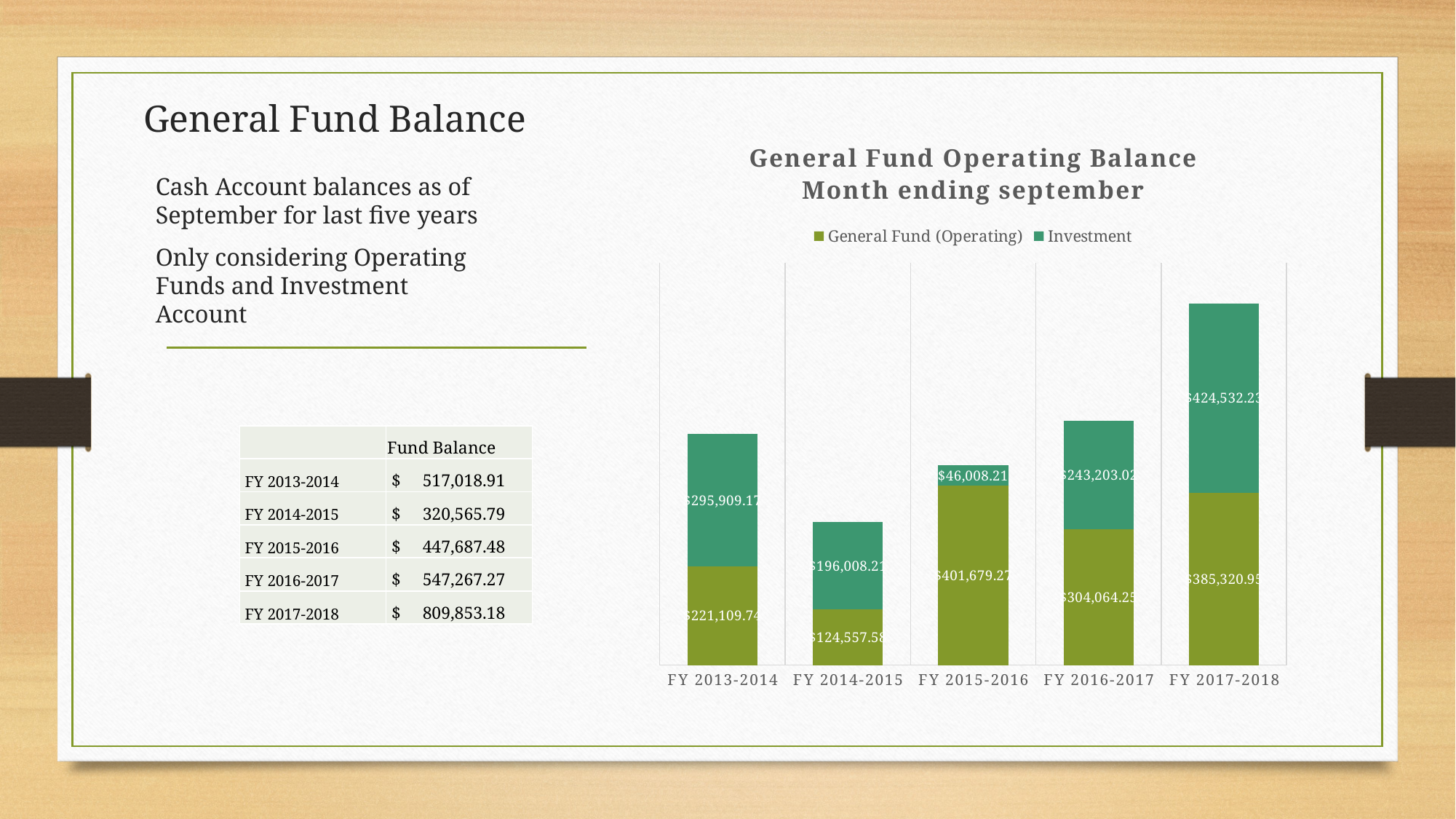
What kind of chart is shown on the slide? Stacked bar chart Which fiscal year has the lowest General Fund (Operating) value? FY 2014-2015 How many fiscal years are shown on the x axis of the chart? 5 Which fiscal year has the highest Investment value? FY 2017-2018 How many series does the chart legend list? 2 What is the difference between the Investment values for FY 2013-2014 and FY 2015-2016? $249,900.96 What is the Investment value for FY 2014-2015? $196,008.21 What is the title of the chart? General Fund Operating Balance Month ending september Which is larger for FY 2016-2017: the General Fund (Operating) value or the Investment value? General Fund (Operating) What is the Investment value for FY 2017-2018? $424,532.23 What is the total of the stacked bar for FY 2017-2018? $809,853.18 What is the General Fund (Operating) value for FY 2015-2016? $401,679.27